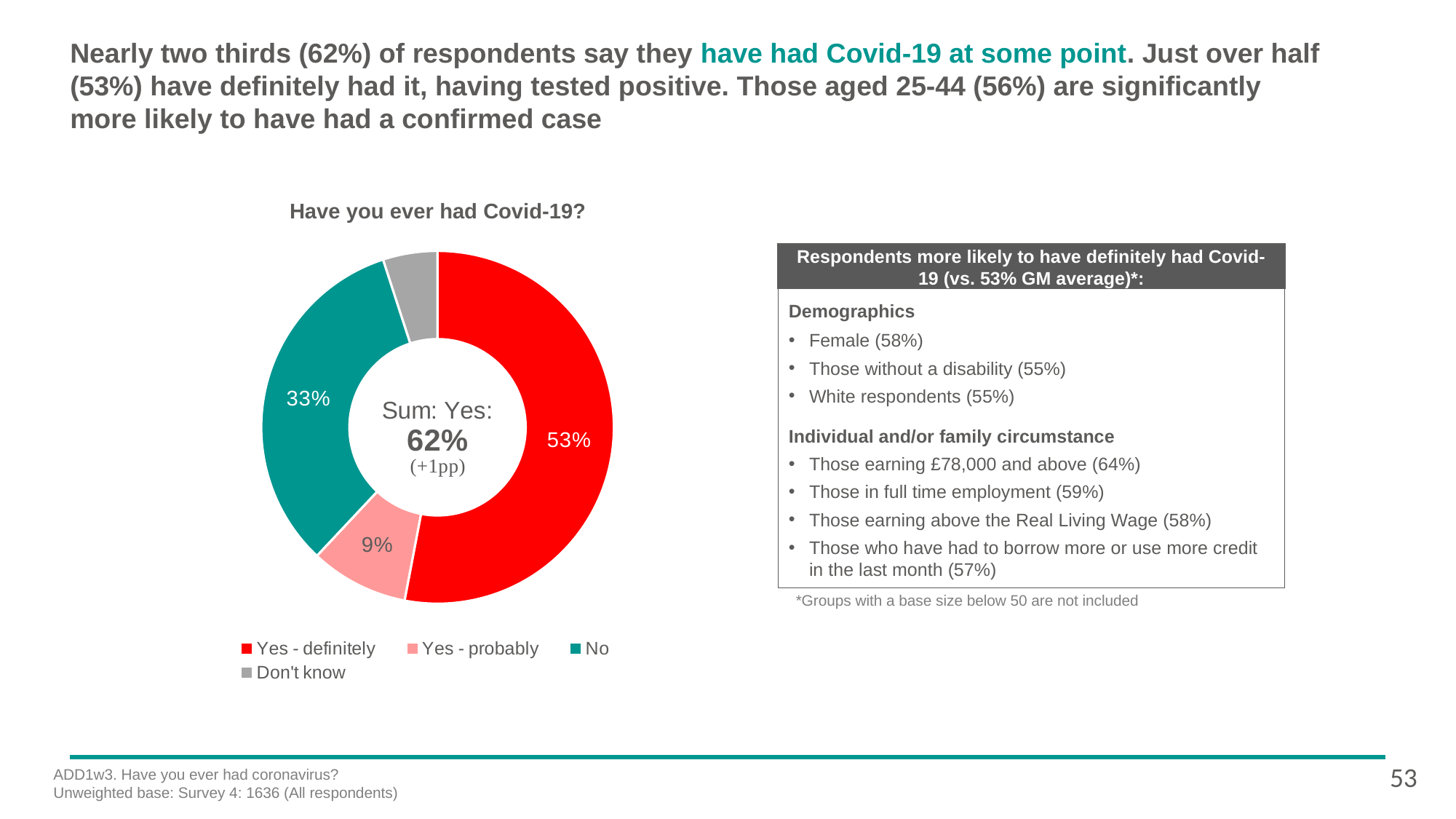
Which response category has the largest share in the "Have you ever had Covid-19?" chart? Yes - definitely What colour is the "No" slice in the "Have you ever had Covid-19?" chart? Teal (green) What percentage of respondents answered "Yes - definitely" in the "Have you ever had Covid-19?" chart? 53% In the "Have you ever had Covid-19?" chart, what is the difference in percentage points between "Yes - definitely" and "No"? 20 percentage points What percentage of respondents answered "Yes - probably" in the "Have you ever had Covid-19?" chart? 9% Which response category has the smallest share in the "Have you ever had Covid-19?" chart? Don't know What type of chart is used to show responses to "Have you ever had Covid-19?"? Pie (donut) chart How many response categories are shown in the legend of the "Have you ever had Covid-19?" chart? 4 What percentage of respondents answered "No" in the "Have you ever had Covid-19?" chart? 33% What is the combined share of respondents who said "Yes" (definitely or probably) in the "Have you ever had Covid-19?" chart? 62% In the "Have you ever had Covid-19?" chart, which is larger: "No" or "Yes - probably"? No What is the title of the pie chart on the slide? Have you ever had Covid-19?